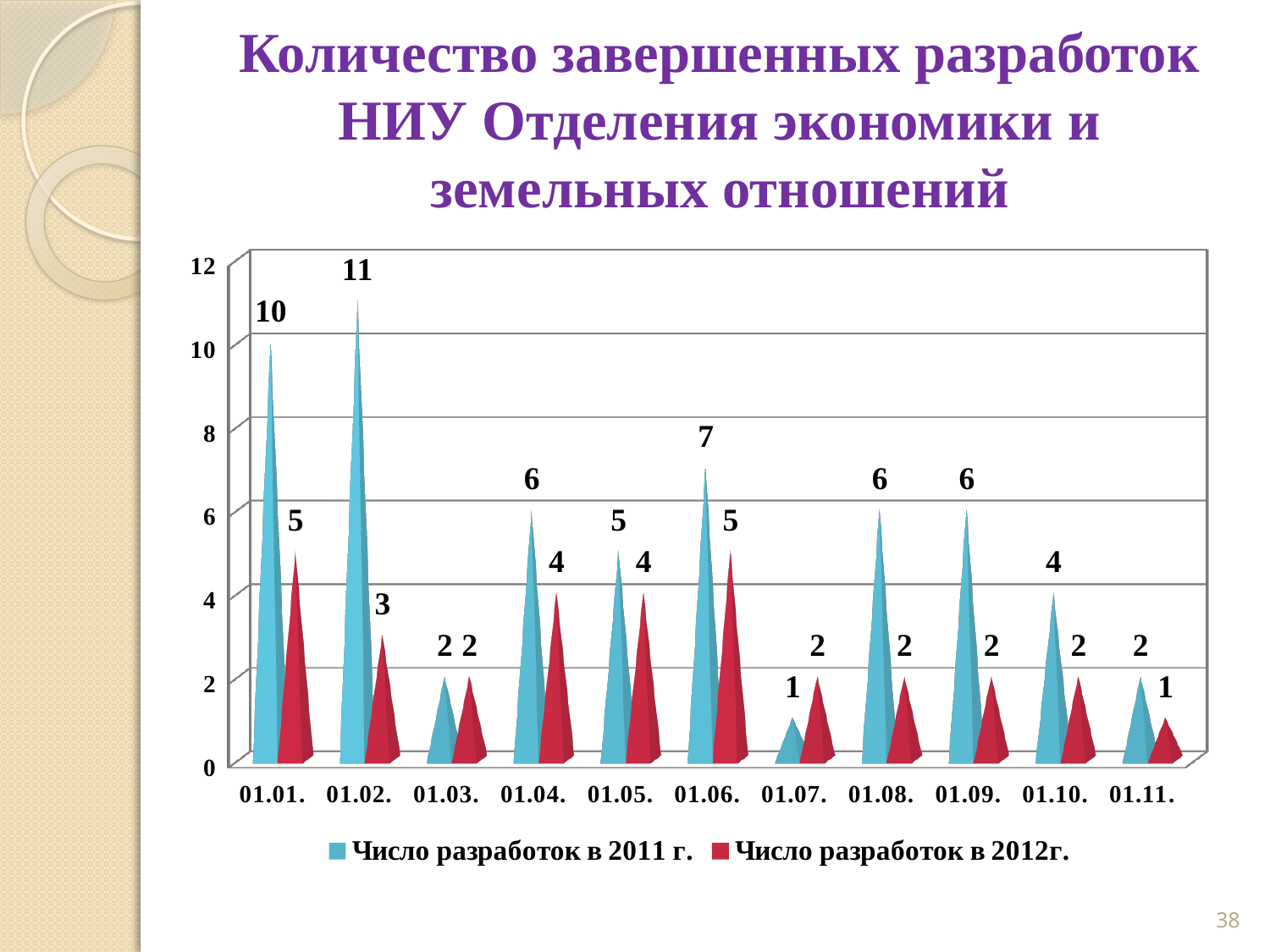
What is the difference between the 2011 and 2012 values for 01.02.? 8 What kind of chart is shown on the slide? bar chart Which category has the lowest value in the series "Число разработок в 2012г."? 01.11. What is the value for 01.02. in the series "Число разработок в 2011 г."? 11 What is the value for 01.06. in the series "Число разработок в 2012г."? 5 Which is larger for 01.07.: the value for 2011 or the value for 2012? 2012 Which category has the highest value in the series "Число разработок в 2011 г."? 01.02. What is the difference between the 2011 and 2012 values for 01.01.? 5 Which colour represents the series "Число разработок в 2012г."? red How many series does the legend list? 2 How many categories are shown on the x axis? 11 What is the value for 01.07. in the series "Число разработок в 2011 г."? 1